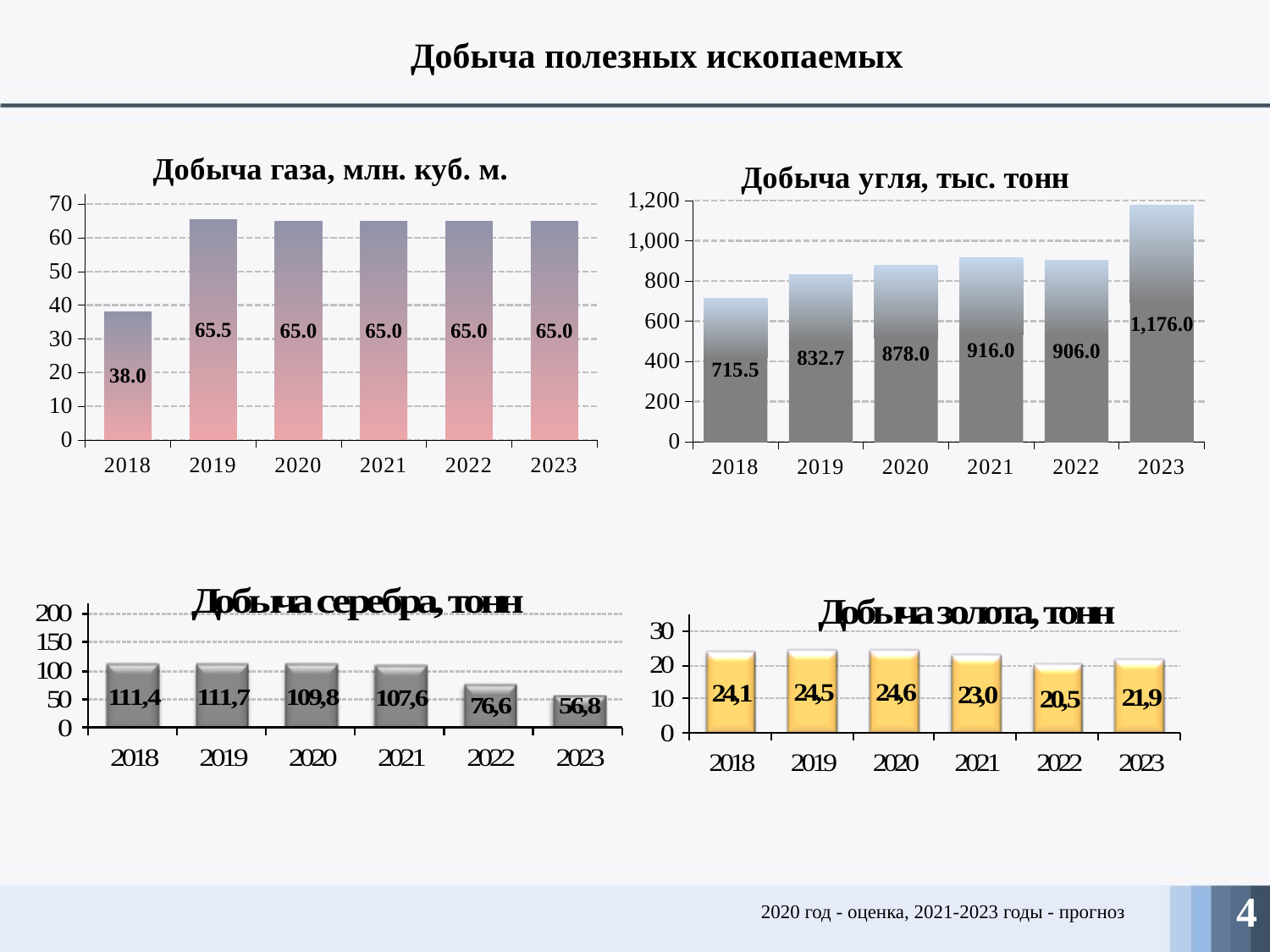
In the chart 'Добыча угля, тыс. тонн', which is larger, the value for 2021 or the value for 2022? 2021 In the chart 'Добыча угля, тыс. тонн', what is the value for 2021? 916.0 In the chart 'Добыча серебра, тонн', do the values generally rise or fall from 2018 to 2023? fall In the chart 'Добыча серебра, тонн', what is the value for 2023? 56,8 In the chart 'Добыча газа, млн. куб. м.', what is the difference between the values for 2019 and 2018? 27.5 In the chart 'Добыча золота, тонн', which year has the highest value? 2020 How many charts are shown on the slide? 4 What kind of chart is 'Добыча угля, тыс. тонн'? bar chart In the chart 'Добыча серебра, тонн', is the value for 2022 greater or less than 100? less In the chart 'Добыча угля, тыс. тонн', which year has the lowest value? 2018 In the chart 'Добыча газа, млн. куб. м.', what is the value for 2018? 38.0 How many years are shown on the x axis of the chart 'Добыча золота, тонн'? 6